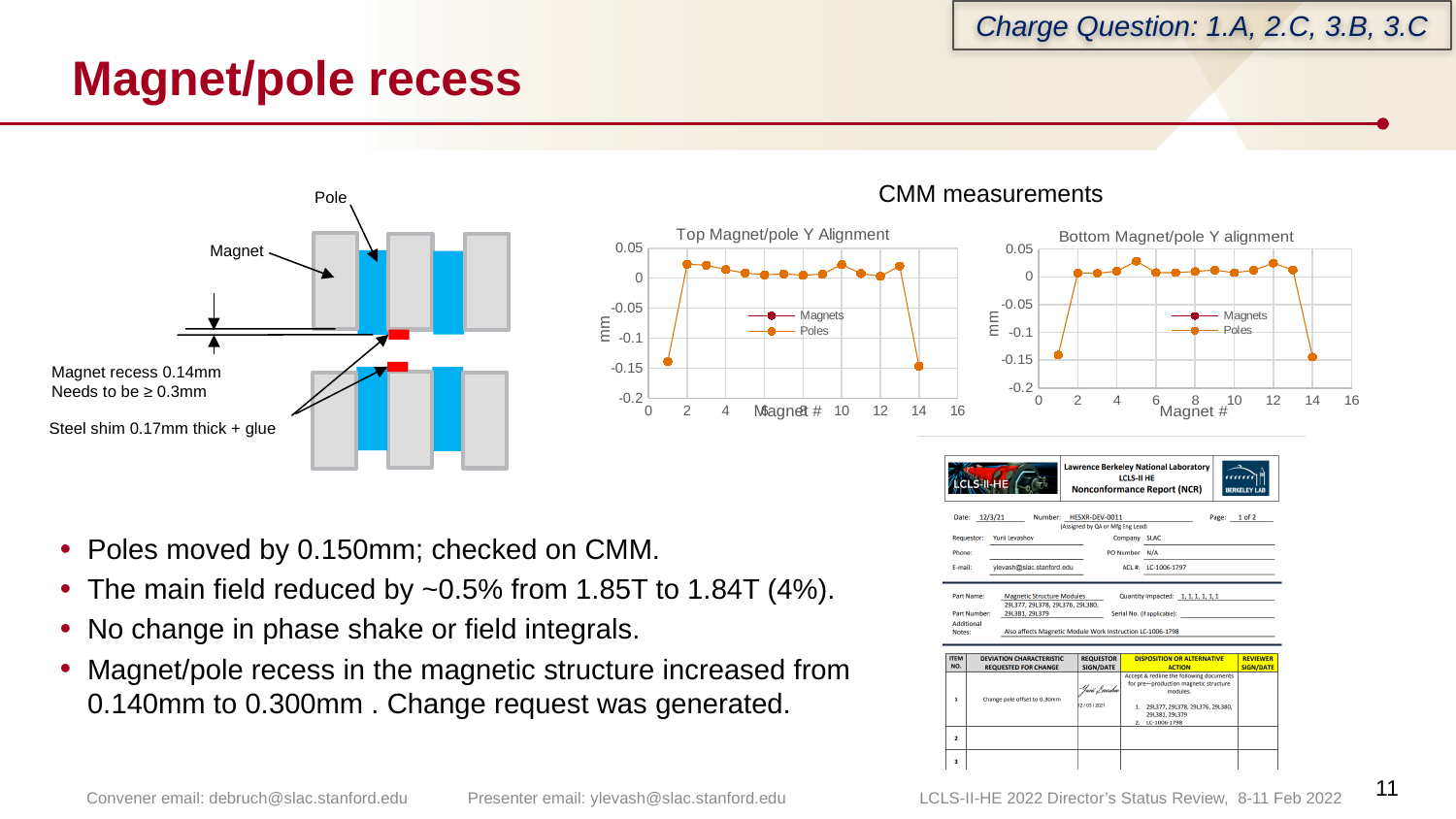
What is the y-axis label of the 'Bottom Magnet/pole Y alignment' chart? mm What kind of chart is the 'Top Magnet/pole Y Alignment' chart? line chart In the 'Top Magnet/pole Y Alignment' chart, is the value at magnet 1 greater or less than -0.1? less How many series does the legend of the 'Bottom Magnet/pole Y alignment' chart list? 2 In the 'Bottom Magnet/pole Y alignment' chart, is the value at magnet 1 greater or less than -0.05? less What is the highest tick value shown on the y-axis of the 'Top Magnet/pole Y Alignment' chart? 0.05 In the 'Top Magnet/pole Y Alignment' chart, which is larger: the value at magnet 2 or the value at magnet 14? magnet 2 In the 'Top Magnet/pole Y Alignment' chart, is the value at magnet 2 greater or less than 0? greater What are the two legend entries in the 'Top Magnet/pole Y Alignment' chart? Magnets and Poles